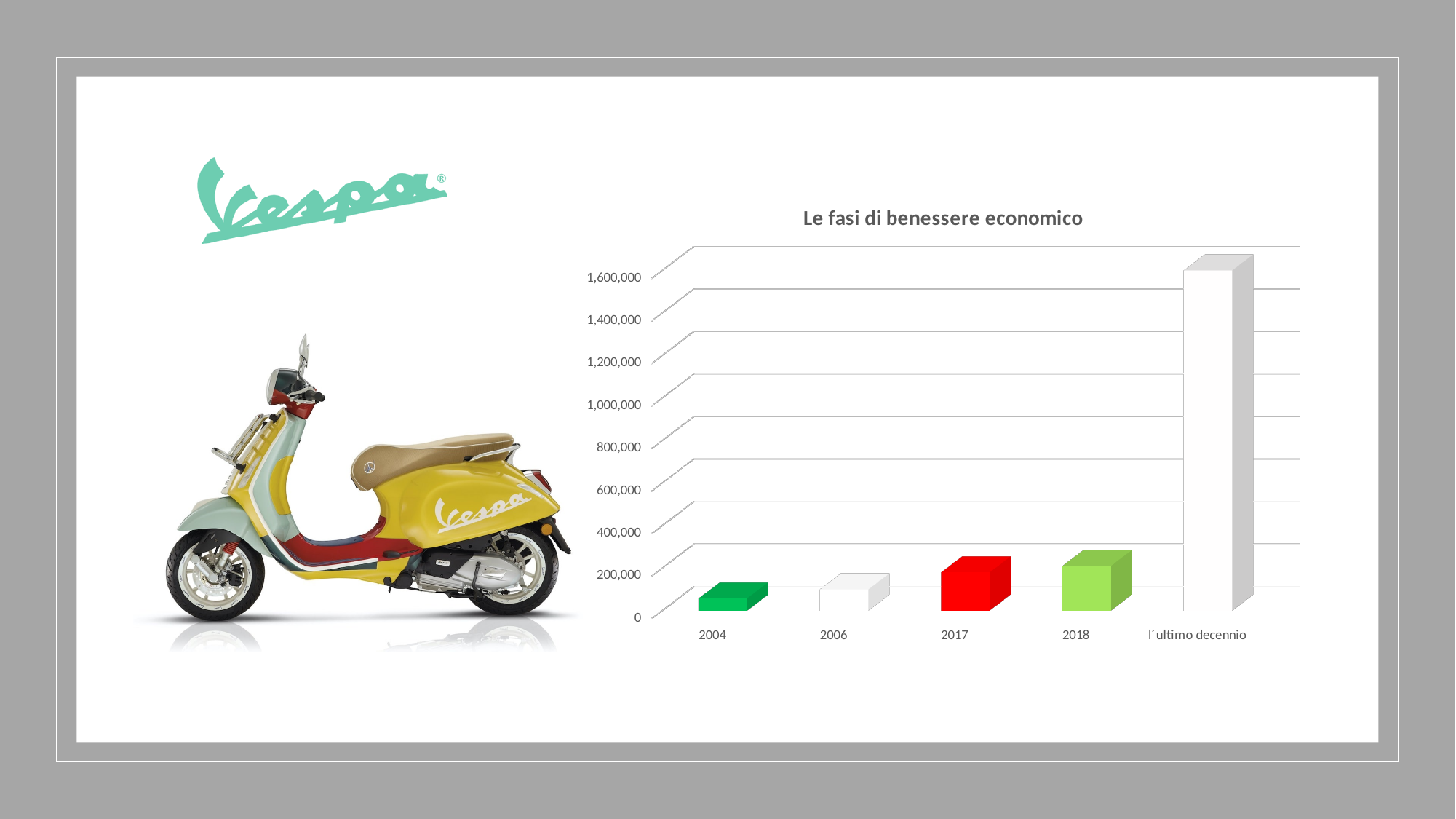
Which category has the highest value in the chart? l´ultimo decennio Is the value for 2018 greater or less than 600,000? less Is the value for 2006 greater or less than 400,000? less How many categories are shown on the x axis of the chart? 5 What kind of chart is shown on the slide? bar chart Do the values rise or fall from left to right along the x axis? rise Which category has the lowest value in the chart? 2004 Is the value for 2004 greater or less than 200,000? less Which is larger, the value for 2018 or the value for 2004? 2018 What is the title of the chart? Le fasi di benessere economico Which is larger, the value for 2017 or the value for 2006? 2017